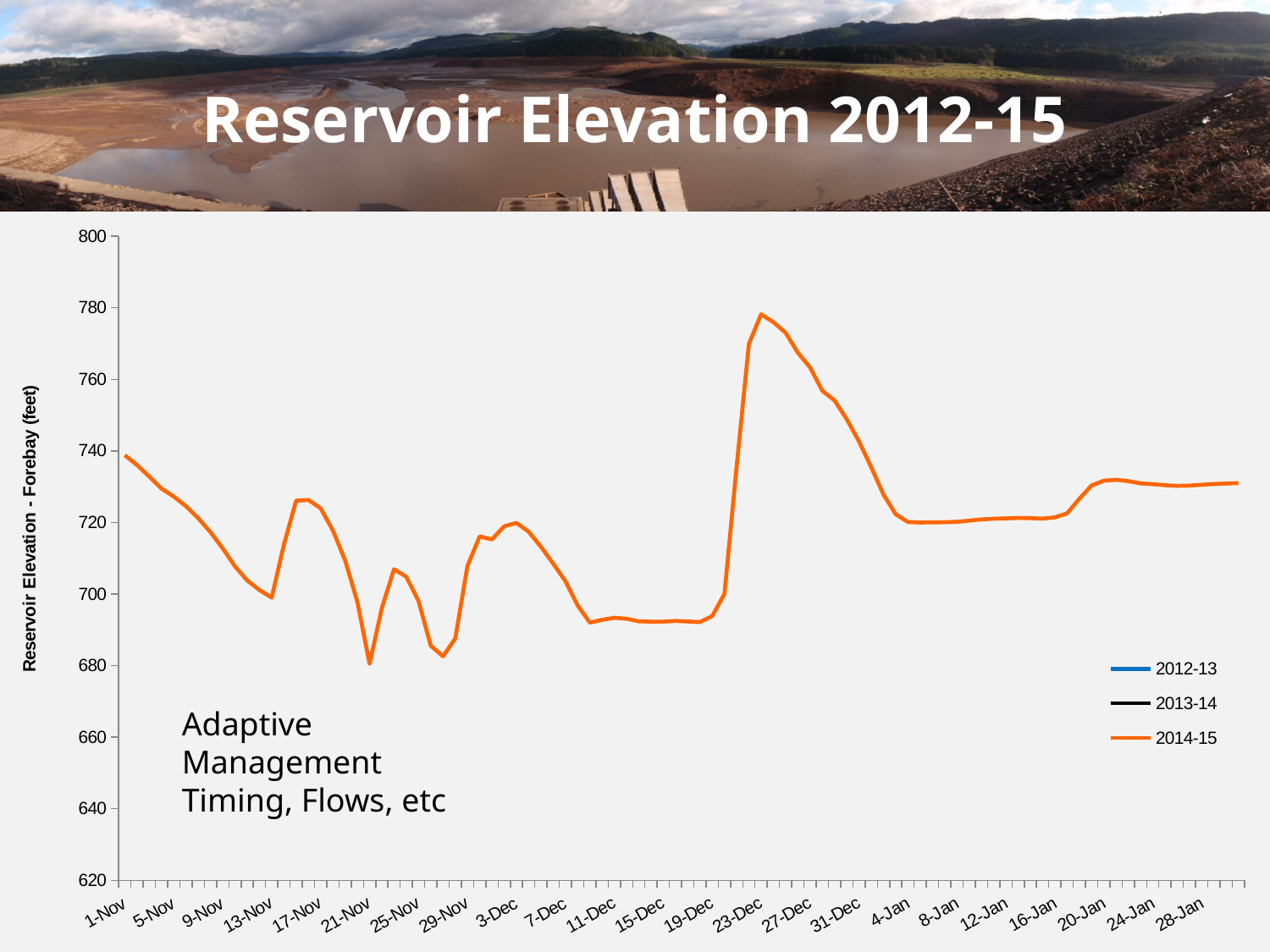
In which month does the 2014-15 line reach its highest value? December Which series is drawn in orange according to the legend? 2014-15 Does the 2014-15 line rise or fall between 1-Nov and 13-Nov? fall Is the highest point of the 2014-15 line greater or less than 760? greater Is the 2014-15 value on 11-Dec greater or less than 700? less Is the 2014-15 value on 28-Jan greater or less than 720? greater What is the title of the vertical axis? Reservoir Elevation - Forebay (feet) What kind of chart is shown on the slide? line chart How many series does the legend list? 3 Around which date does the 2014-15 line reach its lowest value? 21-Nov